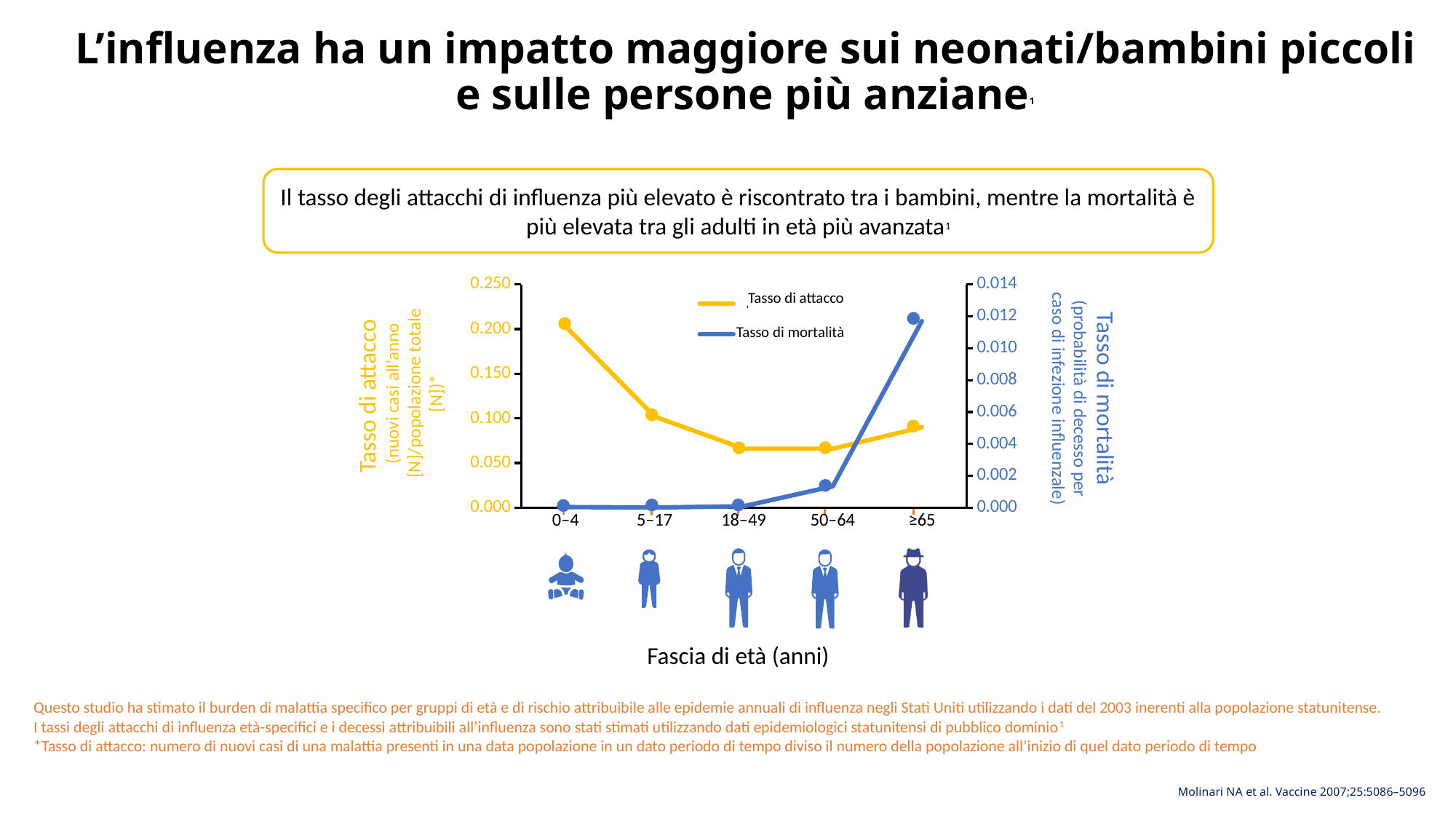
Is the Tasso di attacco for the 0–4 age group greater or less than 0.150? greater Which age group has the highest Tasso di mortalità? ≥65 Which age group has a higher Tasso di attacco, 0–4 or 5–17? 0–4 Does the Tasso di attacco rise or fall from the 0–4 age group to the 18–49 age group? Fall How many series does the legend list? 2 What kind of chart is shown on the slide? Line chart Which age group has the highest Tasso di attacco? 0–4 Is the Tasso di mortalità for the 50–64 age group greater or less than 0.002? less Is the Tasso di attacco for the 5–17 age group greater or less than 0.150? less What colour is the Tasso di mortalità line? Blue How many age groups are plotted along the x axis? 5